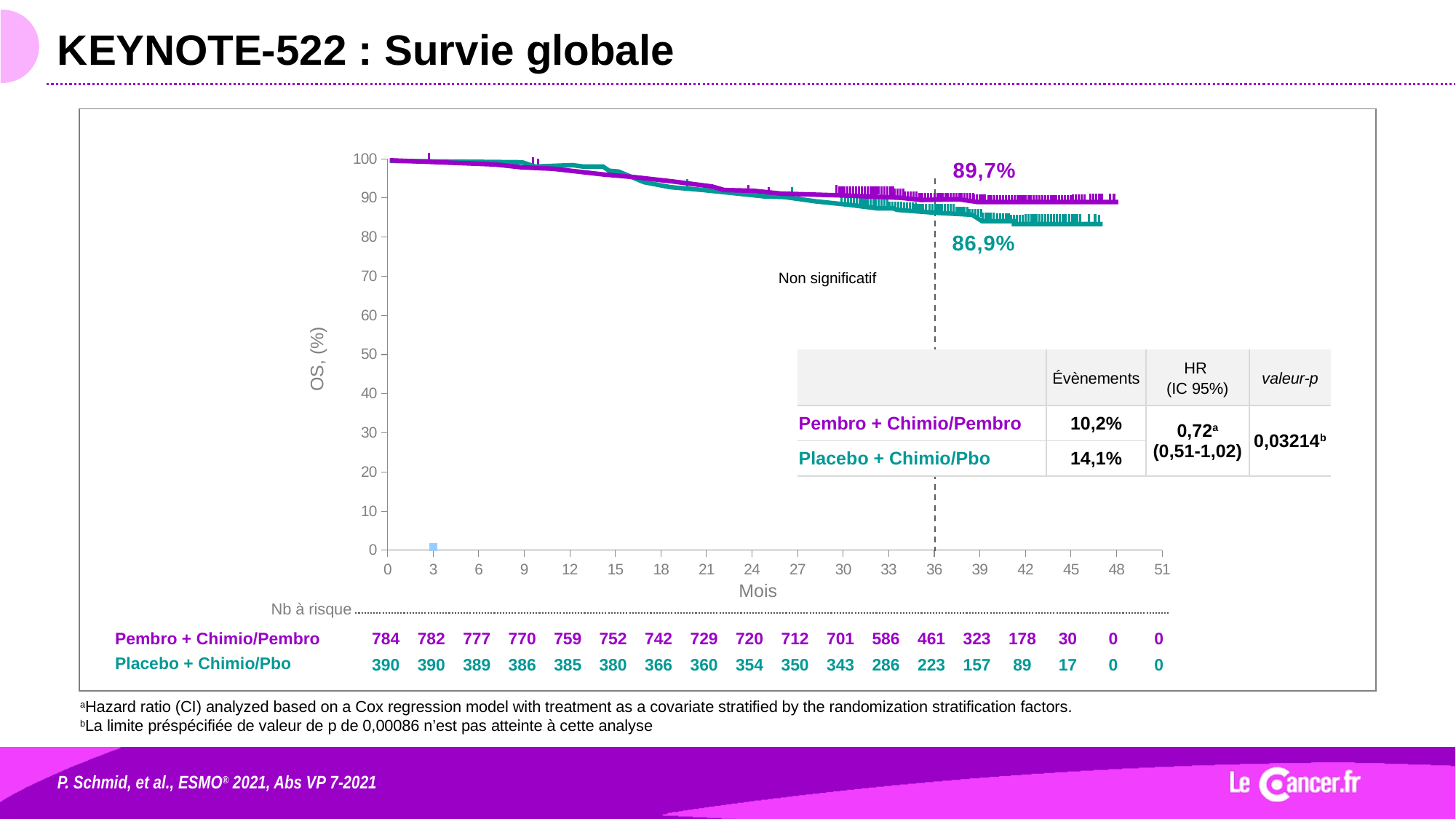
What kind of chart is shown on the slide? Kaplan-Meier survival curve (line chart) What is the difference between the 36-month OS rates of the Pembro + Chimio/Pembro and Placebo + Chimio/Pbo arms? 2,8% Do the OS curves rise or fall as months increase along the x axis? fall What is the event rate for the Placebo + Chimio/Pbo arm in the table? 14,1% What is the number at risk for the Placebo + Chimio/Pbo arm at 36 months? 223 What is the overall survival rate at 36 months for the Placebo + Chimio/Pbo arm? 86,9% How many treatment arms are plotted on the chart? 2 What is the number at risk for the Pembro + Chimio/Pembro arm at 42 months? 178 What is the hazard ratio (95% CI) reported in the table on the chart? 0,72 (0,51-1,02) Which arm has the higher OS rate at 36 months, Pembro + Chimio/Pembro or Placebo + Chimio/Pbo? Pembro + Chimio/Pembro What is the number at risk for the Pembro + Chimio/Pembro arm at 0 months? 784 What is the overall survival rate at 36 months for the Pembro + Chimio/Pembro arm? 89,7%